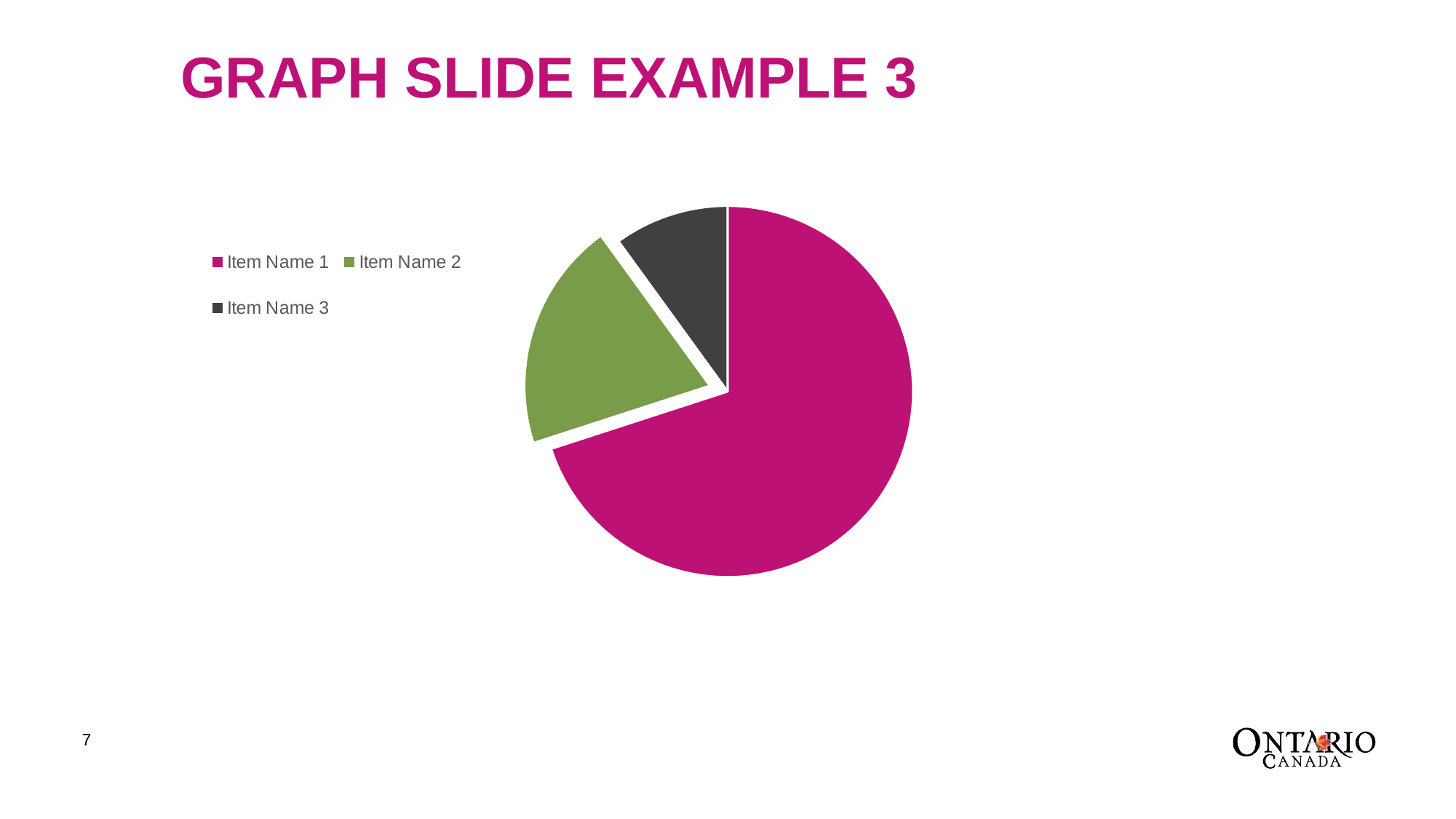
Which slice is larger, Item Name 2 or Item Name 3? Item Name 2 Does Item Name 1 account for more or less than half of the pie? more What kind of chart is shown on the slide? pie chart What is the title of the slide containing the pie chart? GRAPH SLIDE EXAMPLE 3 Which item has the largest slice in the pie chart? Item Name 1 How many slices does the pie chart have? 3 What colour is the slice for Item Name 2 in the pie chart? green How many entries does the legend of the pie chart list? 3 Which item has the smallest slice in the pie chart? Item Name 3 Which slice is larger, Item Name 1 or Item Name 2? Item Name 1